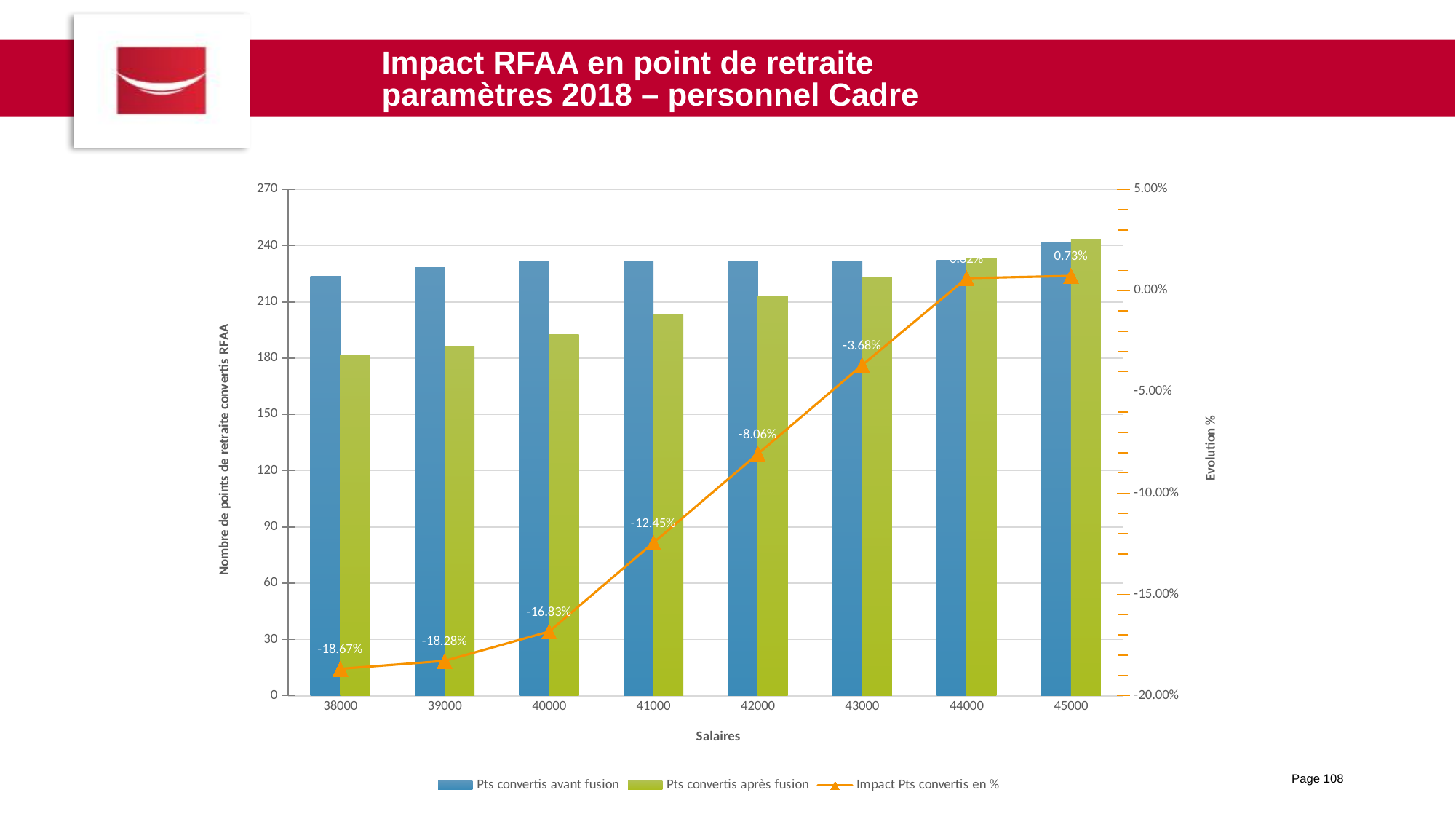
What is the difference in Impact Pts convertis en % between the salaries 42000 and 43000? 4.38 percentage points How many salary categories are shown on the x axis? 8 Is the value of Pts convertis après fusion for the salary 38000 greater or less than 210? less What is the value of Impact Pts convertis en % for the salary 38000? -18.67% For which salary is Impact Pts convertis en % the lowest? 38000 What is the value of Impact Pts convertis en % for the salary 43000? -3.68% What is the value of Impact Pts convertis en % for the salary 42000? -8.06% At the salary 38000, which is larger: Pts convertis avant fusion or Pts convertis après fusion? Pts convertis avant fusion Does Impact Pts convertis en % rise or fall as the salary increases along the x axis? rise For which salary is Impact Pts convertis en % the highest? 45000 What is the value of Impact Pts convertis en % for the salary 45000? 0.73% How many series does the legend list? 3